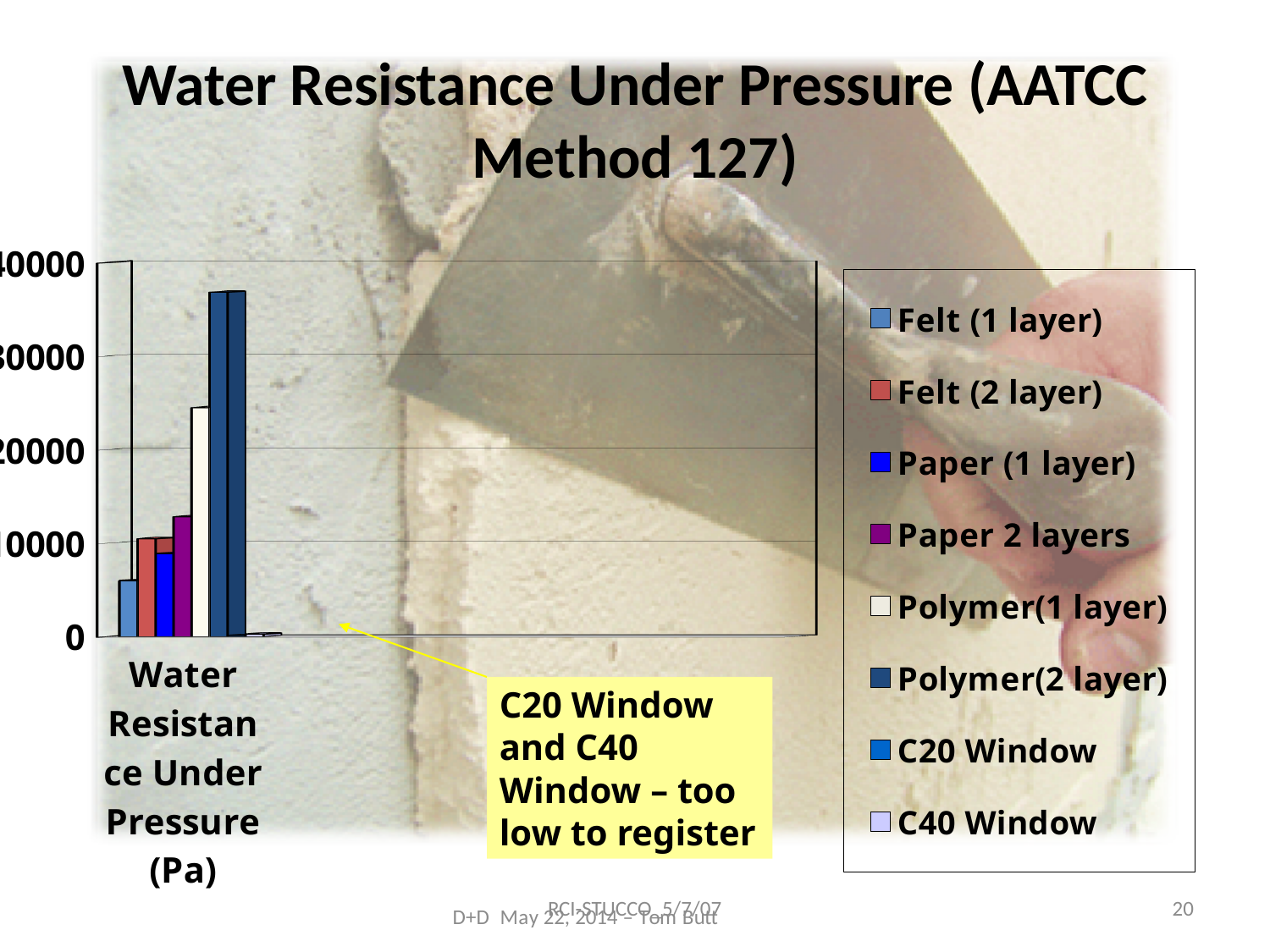
What is the title of the chart? Water Resistance Under Pressure (AATCC Method 127) What kind of chart is shown on the slide? bar chart Is the value for Polymer(1 layer) greater or less than 20000? greater Is the value for Polymer(2 layer) greater or less than 30000? greater Which is larger, the value for Paper 2 layers or Felt (1 layer)? Paper 2 layers Is the value for Paper 2 layers greater or less than 10000? greater According to the annotation, which two series were too low to register? C20 Window and C40 Window How many series does the legend list? 8 Which series has the highest water resistance under pressure? Polymer(2 layer) How many categories are shown on the x axis? 1 Which is larger, the value for Polymer(2 layer) or Polymer(1 layer)? Polymer(2 layer)